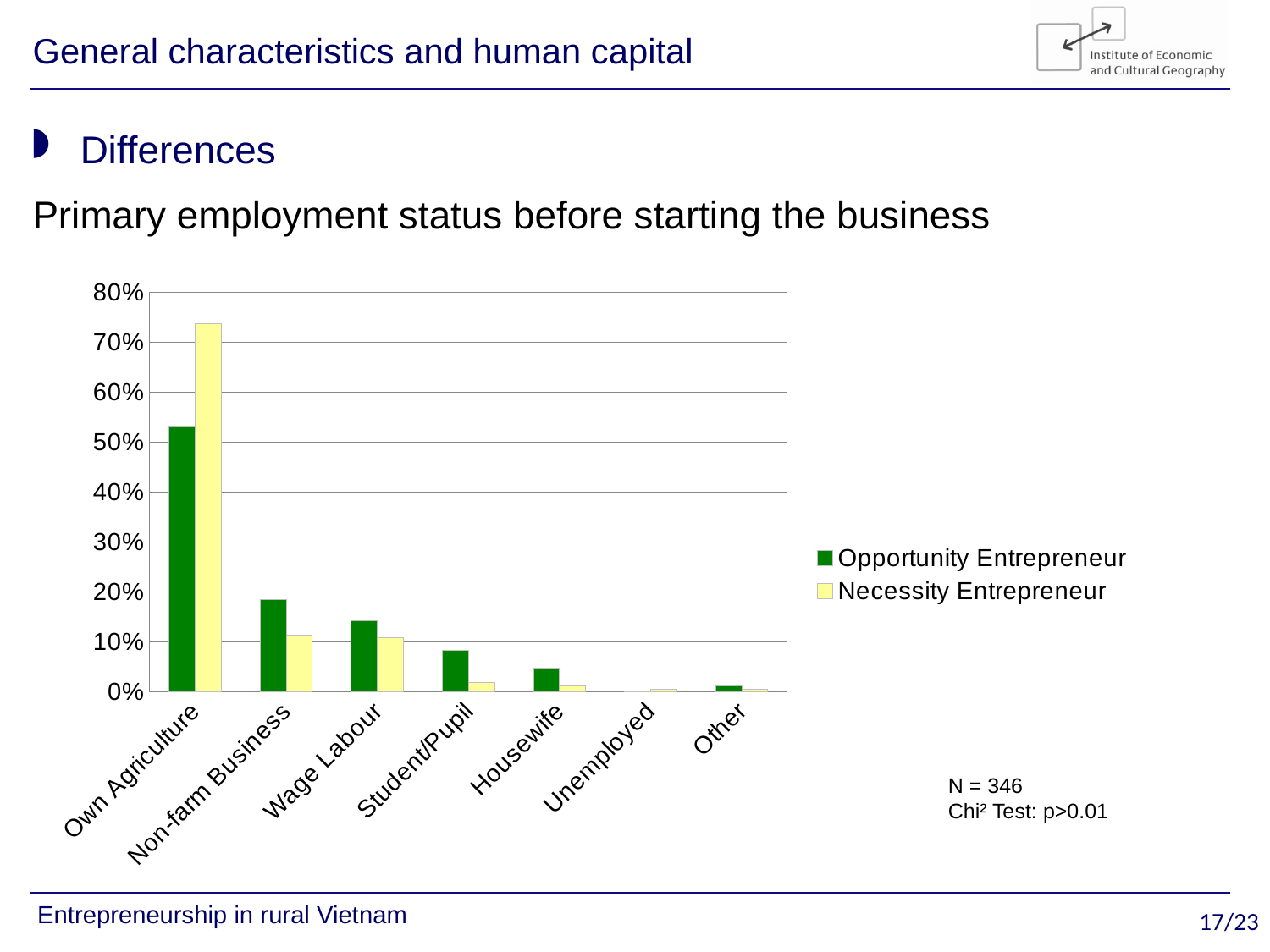
Is the value for Necessity Entrepreneur in Own Agriculture greater or less than 70%? greater For Own Agriculture, which series has the larger value, Opportunity Entrepreneur or Necessity Entrepreneur? Necessity Entrepreneur Is the value for Opportunity Entrepreneur in Wage Labour greater or less than 10%? greater How many employment status categories are shown on the x axis of the chart? 7 Is the value for Opportunity Entrepreneur in Own Agriculture greater or less than 50%? greater Which category has the highest value for Necessity Entrepreneur? Own Agriculture For Non-farm Business, which series has the larger value, Opportunity Entrepreneur or Necessity Entrepreneur? Opportunity Entrepreneur How many series does the chart's legend list? 2 What colour are the bars for the Opportunity Entrepreneur series? green Which category has the highest value for Opportunity Entrepreneur? Own Agriculture What kind of chart is shown on the slide? bar chart